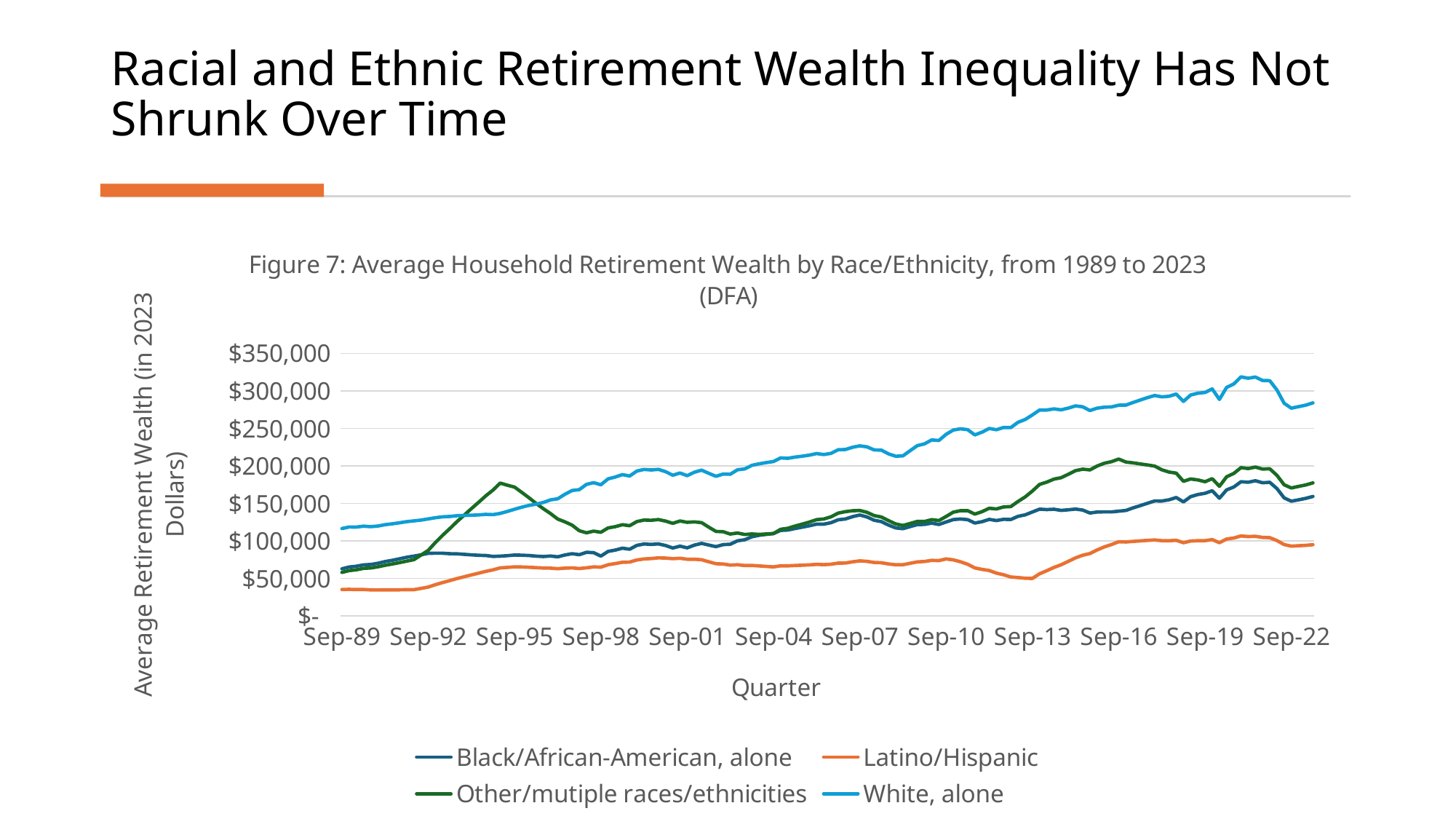
Does the White, alone series generally rise or fall from Sep-89 to Sep-22? rise Which series has the highest value at Sep-22? White, alone How many series does the legend list? 4 Is the value for Latino/Hispanic at Sep-89 greater or less than $50,000? less What is the title of the chart? Figure 7: Average Household Retirement Wealth by Race/Ethnicity, from 1989 to 2023 (DFA) What kind of chart is shown on the slide? line chart Which series has the lowest value at Sep-13? Latino/Hispanic What is the label of the x axis? Quarter Which series has the lowest value at Sep-22? Latino/Hispanic Is the value for Black/African-American, alone at Sep-89 greater or less than $100,000? less Is the value for White, alone at Sep-19 greater or less than $250,000? greater At Sep-95, which is larger: Other/mutiple races/ethnicities or White, alone? Other/mutiple races/ethnicities